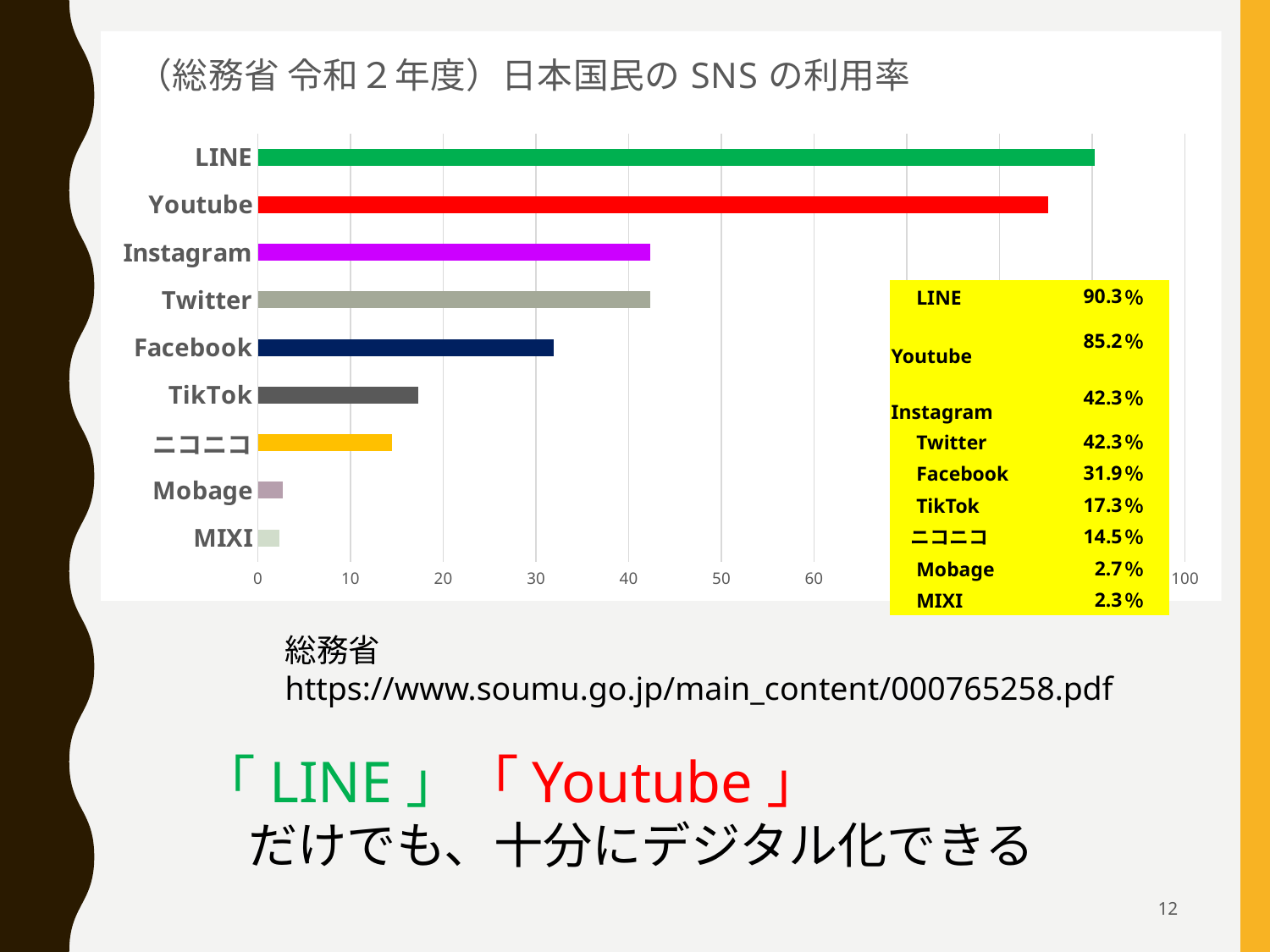
How many SNS categories are shown in the chart? 9 What is the difference between the usage rates of LINE and Youtube? 5.1% What is the difference between the usage rates of Facebook and TikTok? 14.6% Which has a higher usage rate, Youtube or Instagram? Youtube What is the usage rate for LINE? 90.3% What is the usage rate for ニコニコ? 14.5% Which SNS has the lowest usage rate? MIXI What is the usage rate for Facebook? 31.9% What kind of chart is shown on the slide? bar chart What is the title of the chart? （総務省 令和２年度）日本国民の SNS の利用率 Which SNS has the highest usage rate? LINE Is the value for TikTok greater or less than 20? less